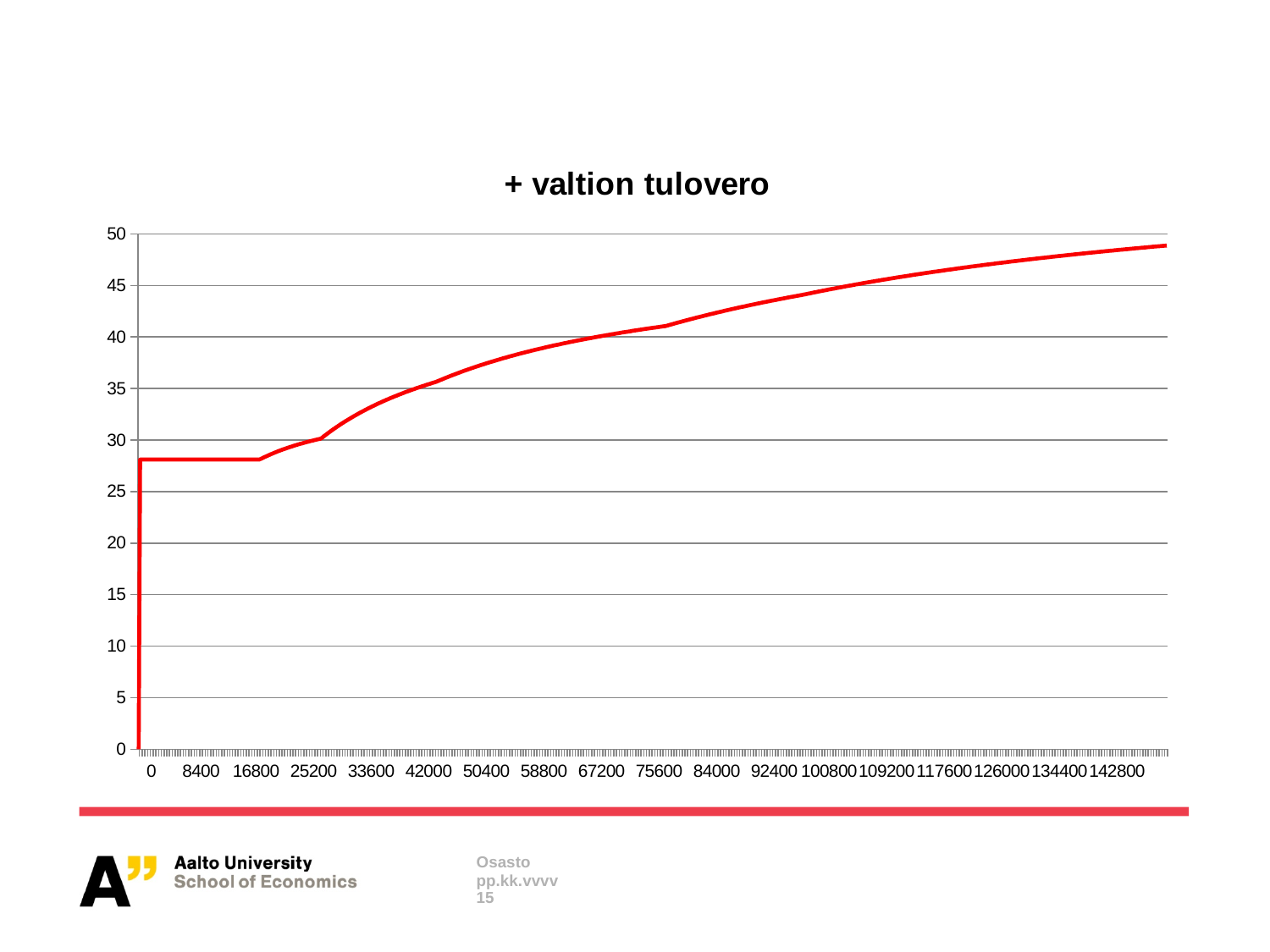
What is the title of the chart? + valtion tulovero Which is larger, the value at 8400 or the value at 142800? 142800 Is the value for 16800 greater or less than 30? less What is the highest value shown on the y-axis? 50 What kind of chart is shown on the slide? line chart Is the value for 33600 greater or less than 30? greater Is the value for 50400 greater or less than 35? greater Do the values of the line generally rise or fall as the x-axis values increase? rise